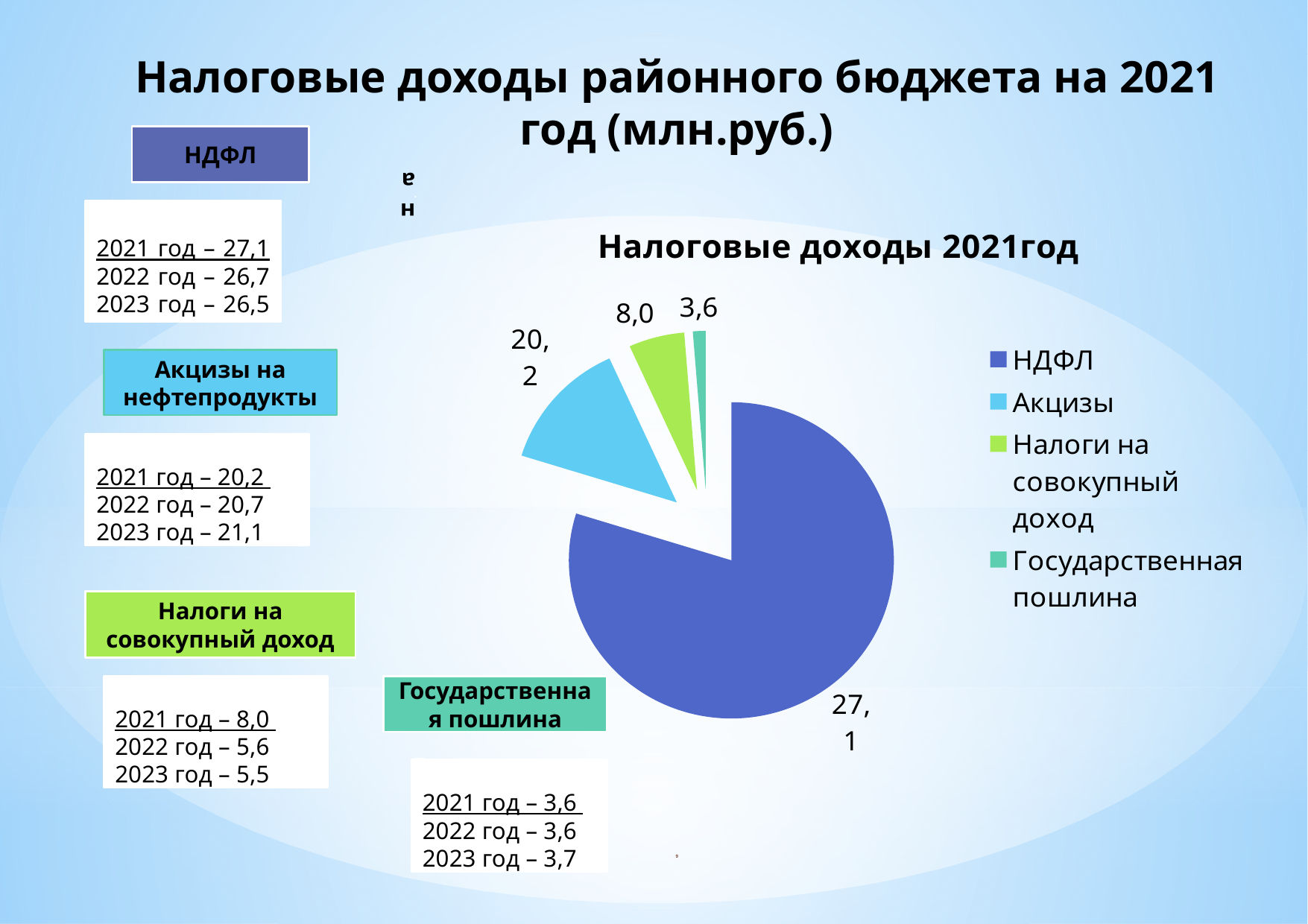
What is the title of the pie chart? Налоговые доходы 2021год What is the value of the Акцизы slice in the pie chart? 20,2 Which is larger in the pie chart: Налоги на совокупный доход or Государственная пошлина? Налоги на совокупный доход What is the difference between the НДФЛ and Акцизы values in the pie chart? 6,9 What is the value of the Налоги на совокупный доход slice in the pie chart? 8,0 Which category has the smallest slice in the pie chart? Государственная пошлина Which category has the largest slice in the pie chart? НДФЛ How many entries does the legend of the pie chart list? 4 What is the value of the Государственная пошлина slice in the pie chart? 3,6 What is the value of the НДФЛ slice in the pie chart? 27,1 How many slices does the pie chart have? 4 What kind of chart is shown on the slide? Pie chart